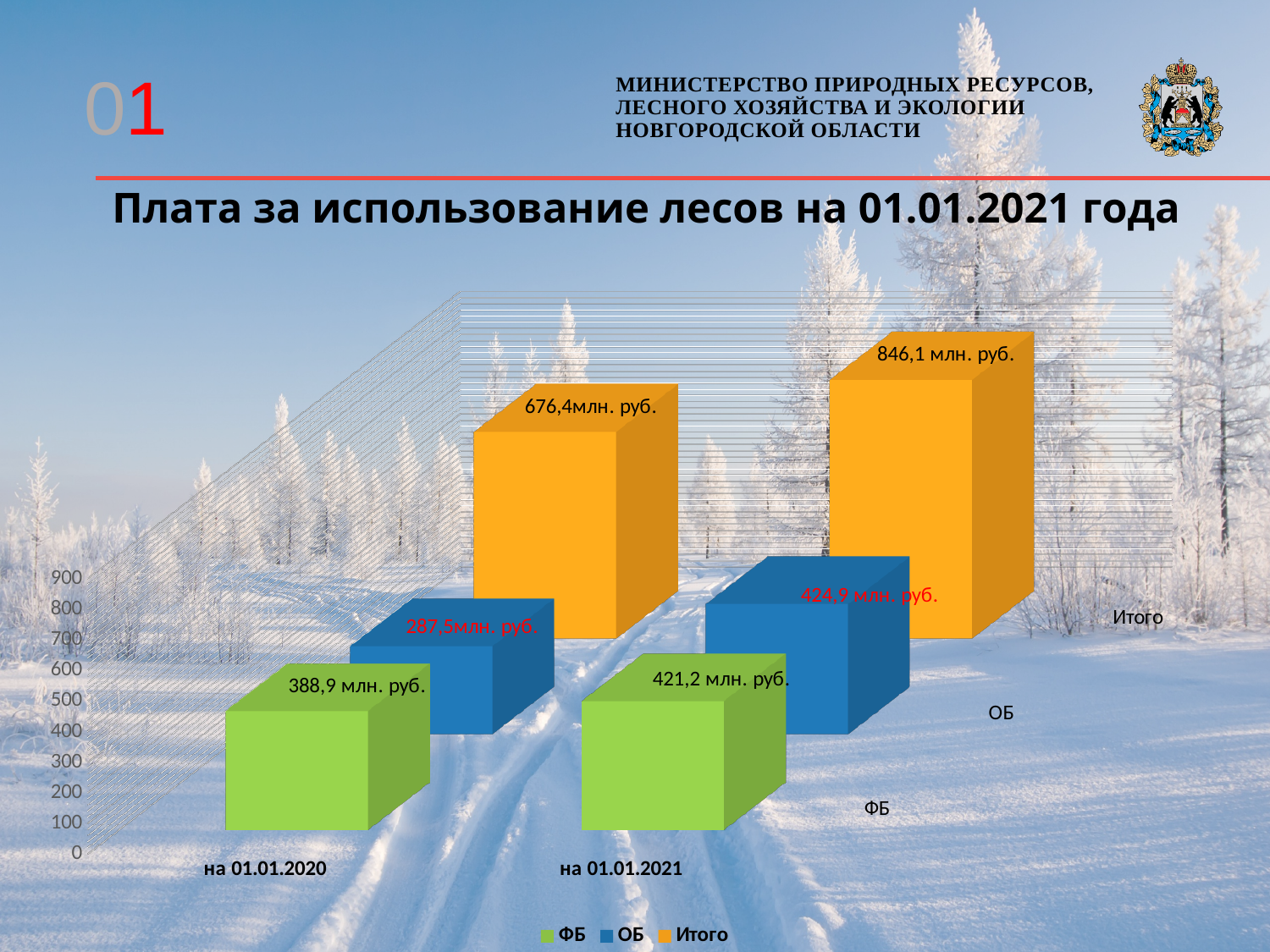
What is the value for Итого on 01.01.2020? 676,4 млн. руб. What is the value for ФБ on 01.01.2020? 388,9 млн. руб. Which is larger: ФБ on 01.01.2020 or ОБ on 01.01.2020? ФБ on 01.01.2020 Which series has the lowest value on 01.01.2020? ОБ Does the ФБ value rise or fall from 01.01.2020 to 01.01.2021? Rise How many series does the legend list? 3 By how much did Итого increase from 01.01.2020 to 01.01.2021? 169,7 млн. руб. What is the difference between the ОБ values on 01.01.2021 and 01.01.2020? 137,4 млн. руб. What is the value for ОБ on 01.01.2021? 424,9 млн. руб. What kind of chart is shown on the slide? Bar chart What is the value for Итого on 01.01.2021? 846,1 млн. руб. Which category has the highest Итого value? на 01.01.2021